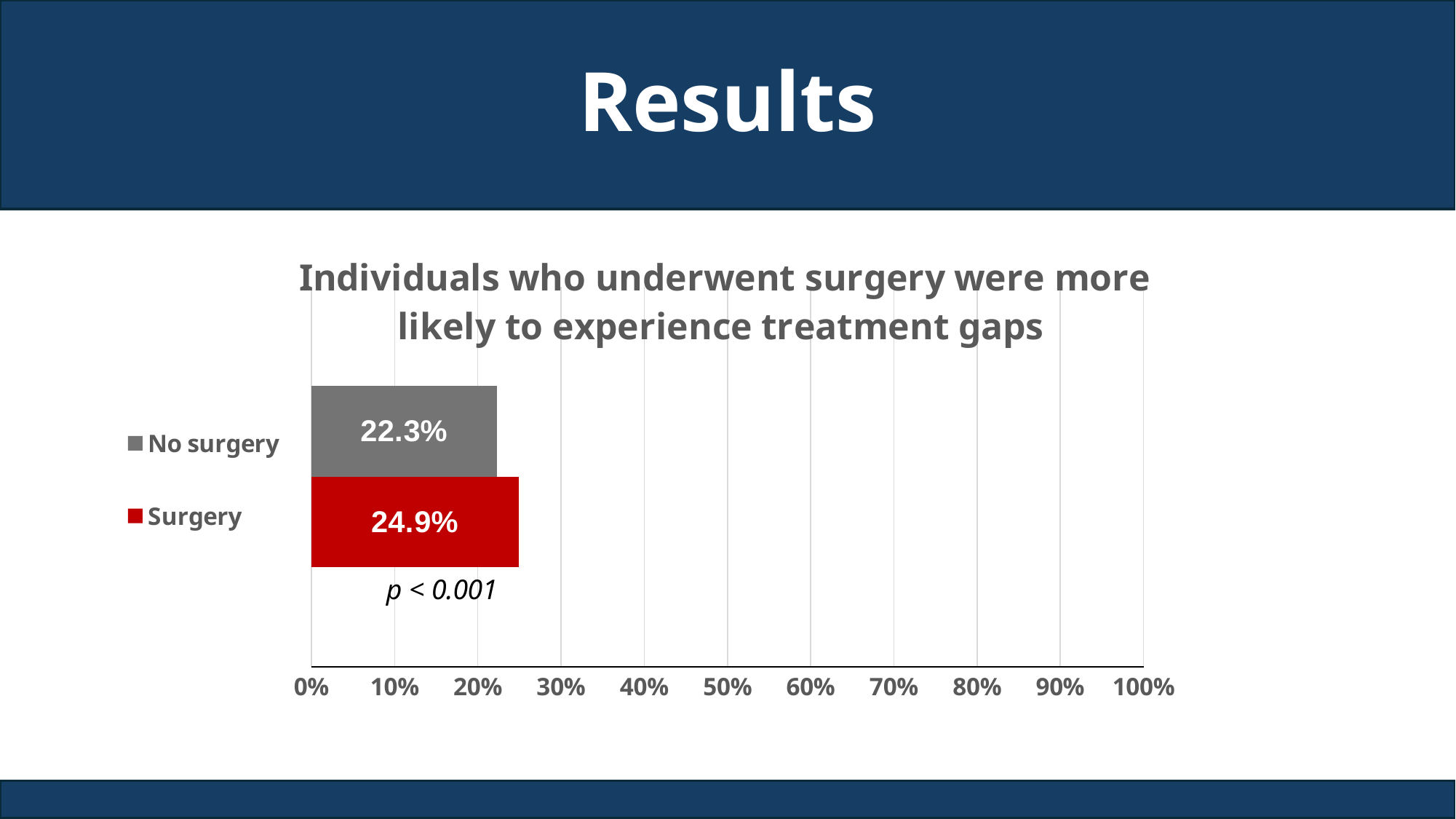
What is the maximum value shown on the x axis? 100% Which group has the lowest value? No surgery What colour is the Surgery bar? red What is the value for Surgery? 24.9% What is the value for No surgery? 22.3% Is the value for Surgery greater or less than 30%? less What is the difference between the Surgery and No surgery values? 2.6% How many series does the legend list? 2 What kind of chart is shown on the slide? bar chart Which group has the higher value, Surgery or No surgery? Surgery What is the title of the chart? Individuals who underwent surgery were more likely to experience treatment gaps Is the value for No surgery greater or less than 20%? greater